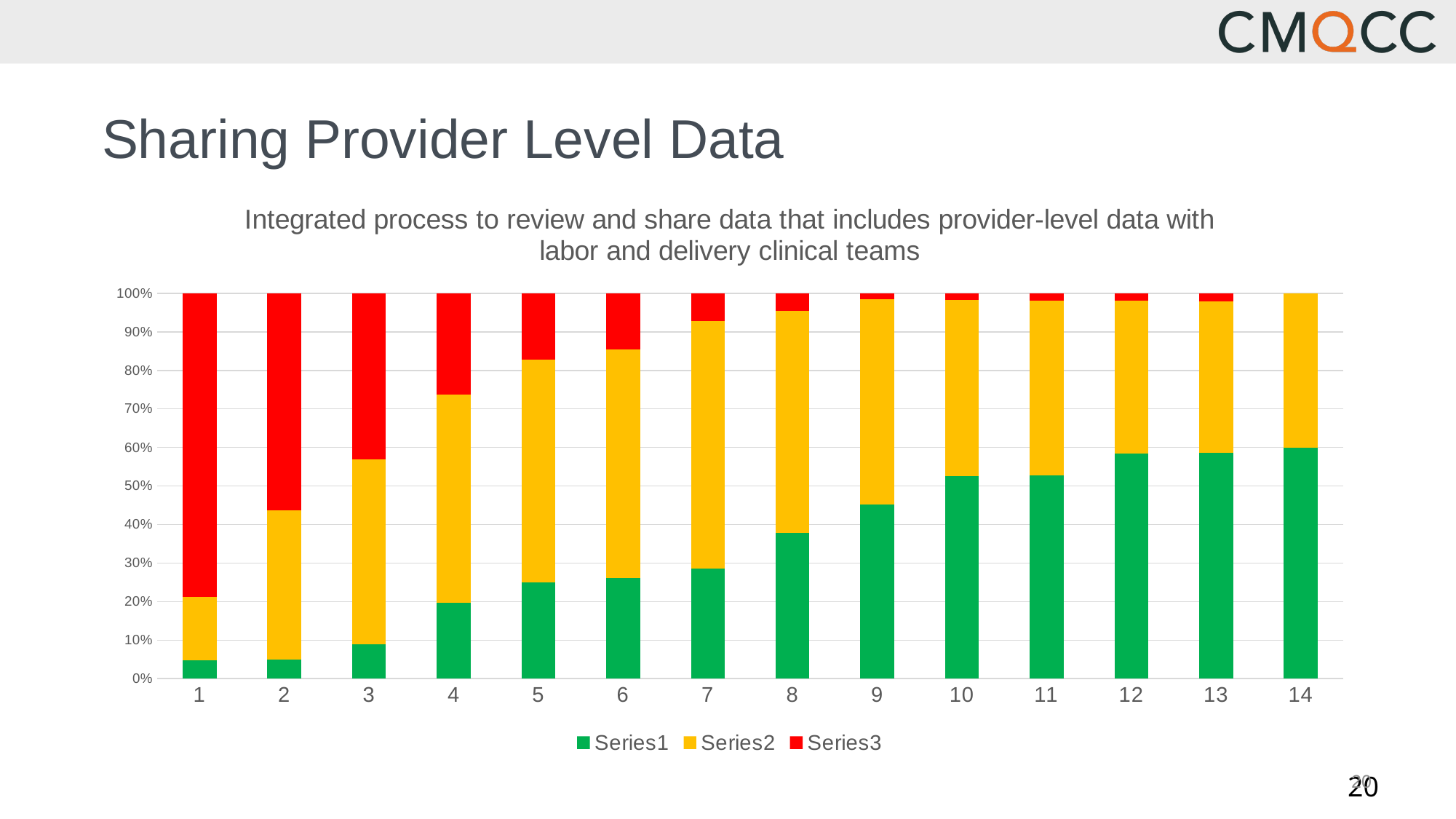
How many series does the legend list? 3 What colour represents Series3 in the chart? red Is the Series3 value for category 1 greater or less than 70%? greater What kind of chart is shown on the slide? bar chart Do the Series1 values generally rise or fall from category 1 to category 14? rise Which category has no visible Series3 segment, i.e. the smallest Series3 value? 14 Which has the larger Series1 value, category 3 or category 9? category 9 Is the Series1 value for category 12 greater or less than 50%? greater Is the Series1 value for category 9 greater or less than 50%? less How many categories are shown along the x axis? 14 Which category has the largest Series3 segment? 1